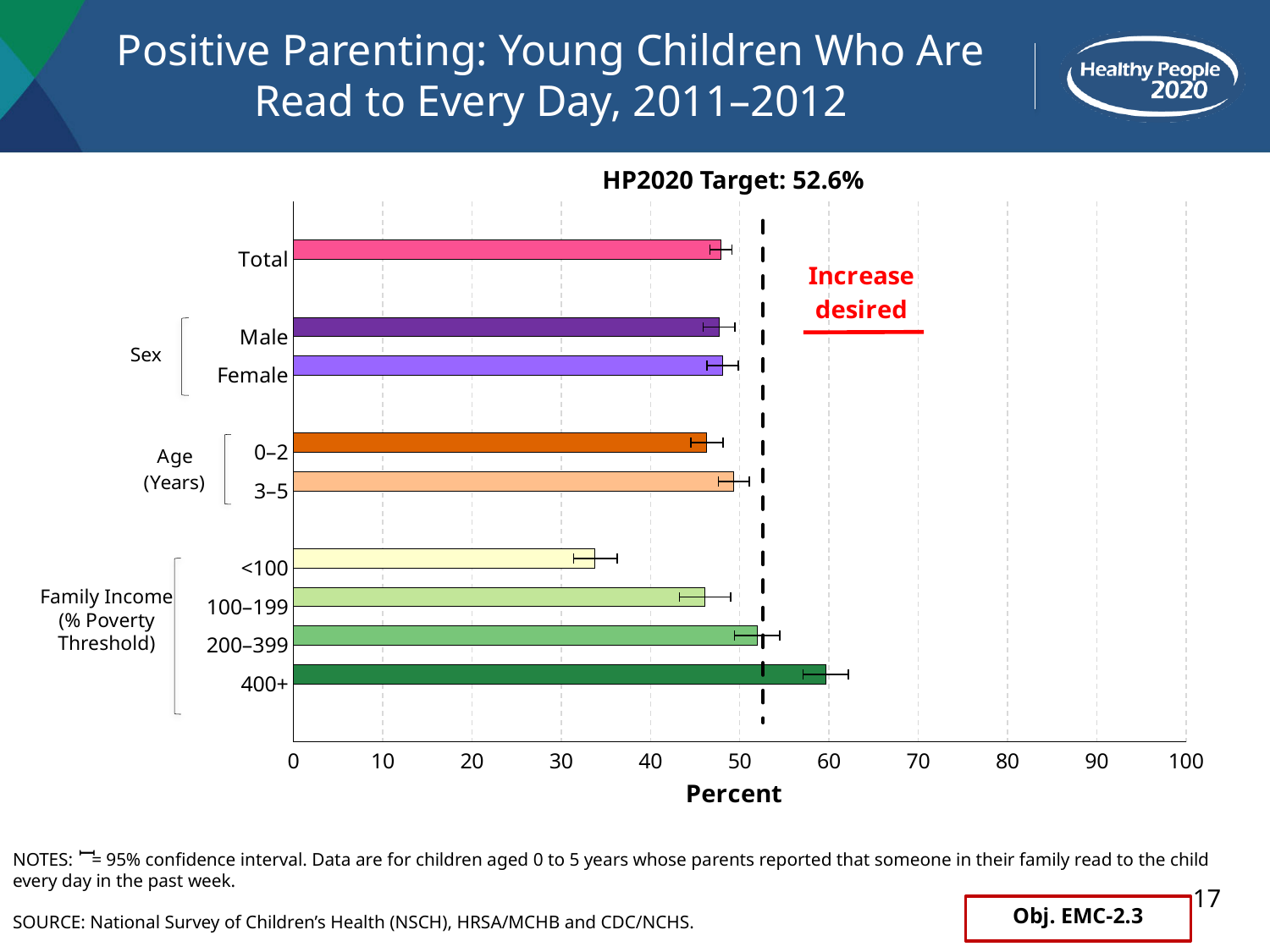
What kind of chart is shown on the slide? bar chart Which category has the lowest percentage of young children read to every day? <100 What is the label of the x axis? Percent Is the value for Total greater or less than 50? less Is the value for the 400+ family income group greater or less than 50? greater Is the value for the <100 family income group greater or less than 40? less Which is larger, the value for the 400+ income group or the value for the <100 income group? 400+ What is the HP2020 Target shown on the chart? 52.6% Which category has the highest percentage of young children read to every day? 400+ How many bars (categories) are plotted in the chart? 9